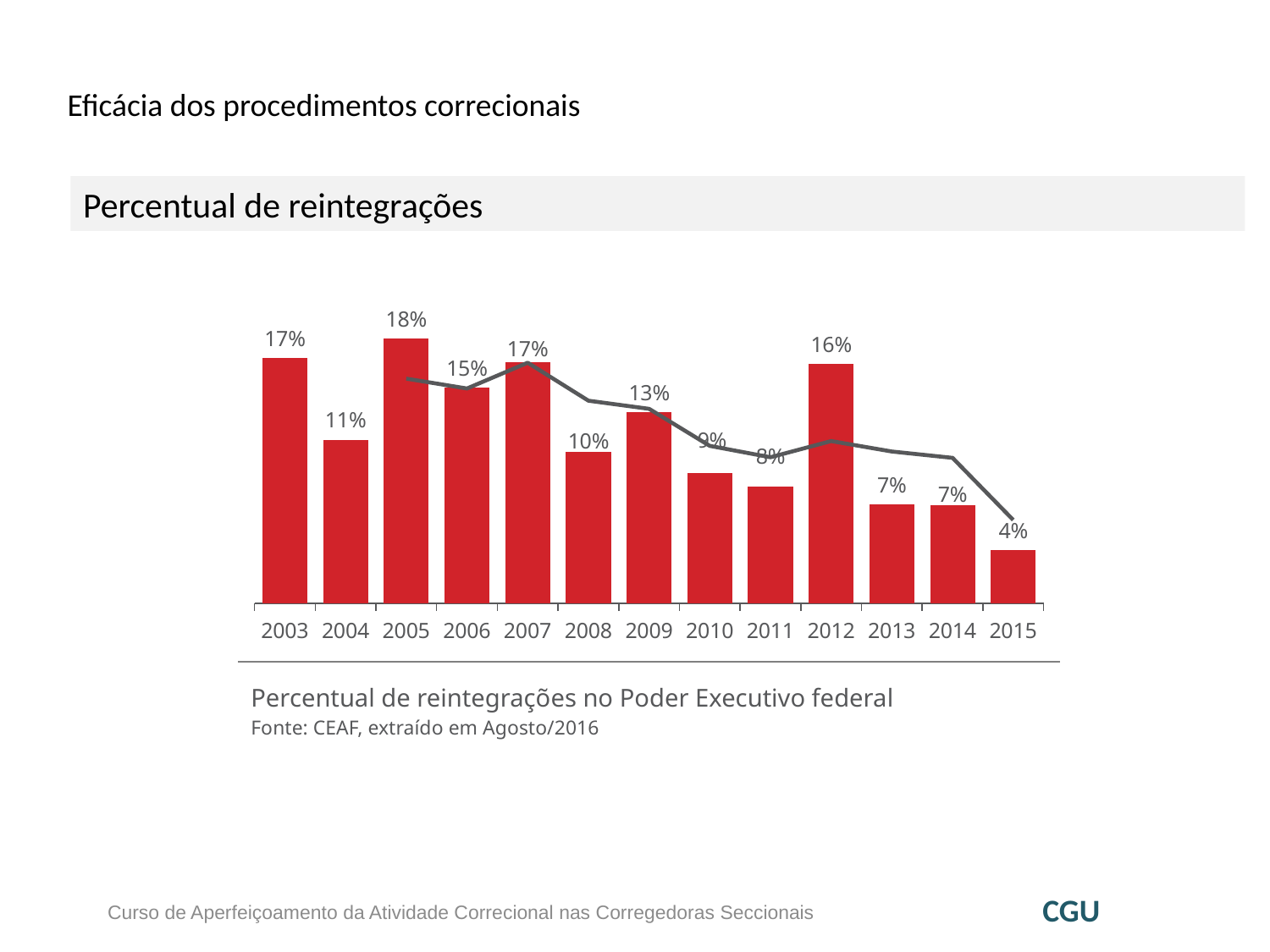
What is the percentage of reintegrations shown for 2005? 18% Which year has the lowest percentage of reintegrations? 2015 Do the bar values generally rise or fall from 2003 to 2015? Fall What is the source cited below the chart? CEAF, extraído em Agosto/2016 Which year has the highest percentage of reintegrations? 2005 What is the difference between the values for 2012 and 2013? 9% What kind of chart is used to show the percentage of reintegrations? Bar chart How many years are shown on the x axis of the chart? 13 What is the value shown for 2015? 4% What is the value shown for 2012? 16% What is the difference between the values for 2005 and 2015? 14% Which year has a larger value, 2004 or 2009? 2009